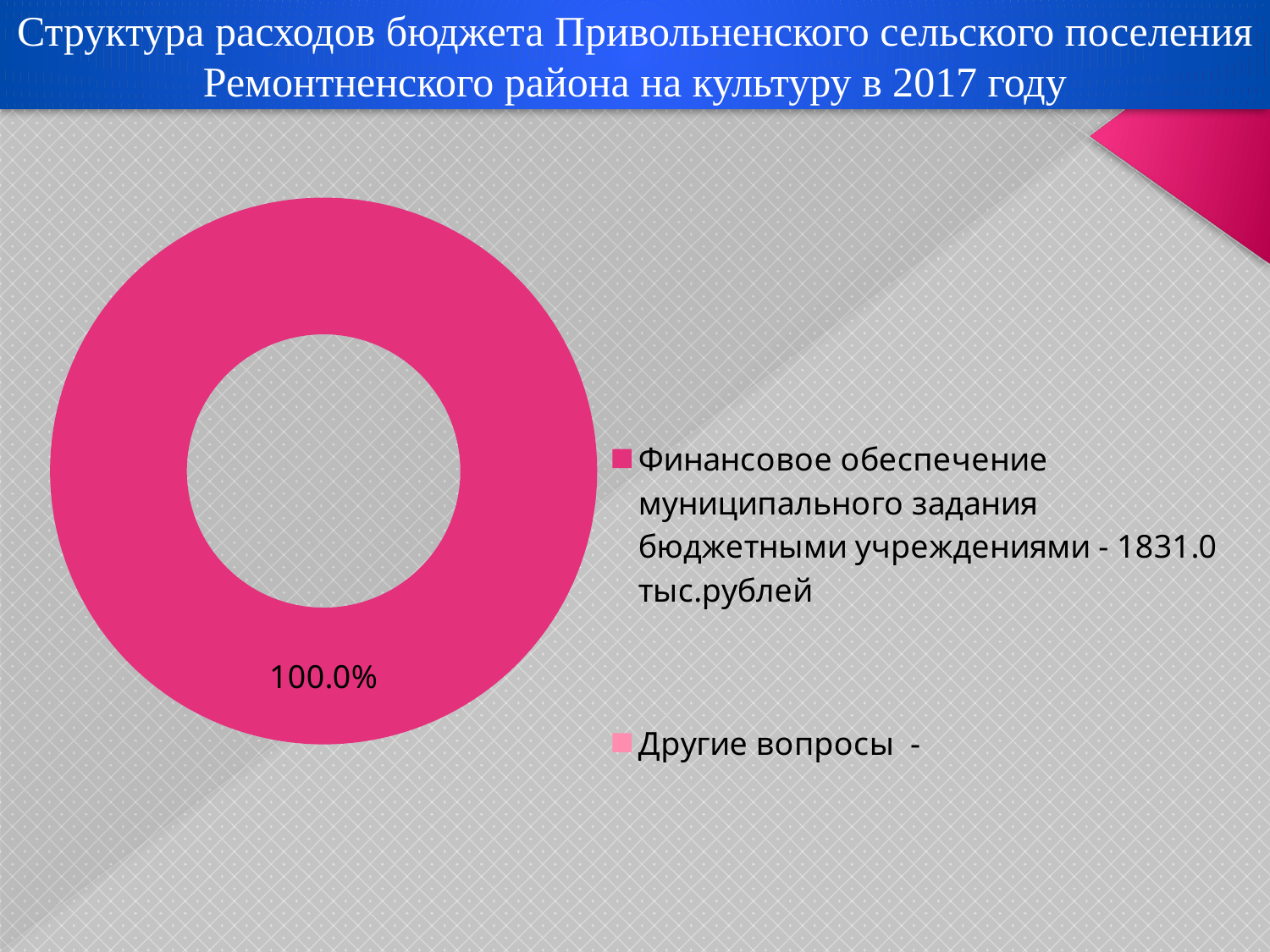
What amount is given in the legend for "Финансовое обеспечение муниципального задания бюджетными учреждениями"? 1831.0 тыс.рублей What kind of chart is shown on the slide? Doughnut (pie) chart Which year does the chart refer to? 2017 What is the name of the second legend entry? Другие вопросы Which category accounts for the largest share of the chart? Финансовое обеспечение муниципального задания бюджетными учреждениями How many entries does the legend list? 2 What share of the chart does the slice for "Финансовое обеспечение муниципального задания бюджетными учреждениями" represent? 100.0% What is the title of the slide? Структура расходов бюджета Привольненского сельского поселения Ремонтненского района на культуру в 2017 году What is the percentage label printed on the chart? 100.0%